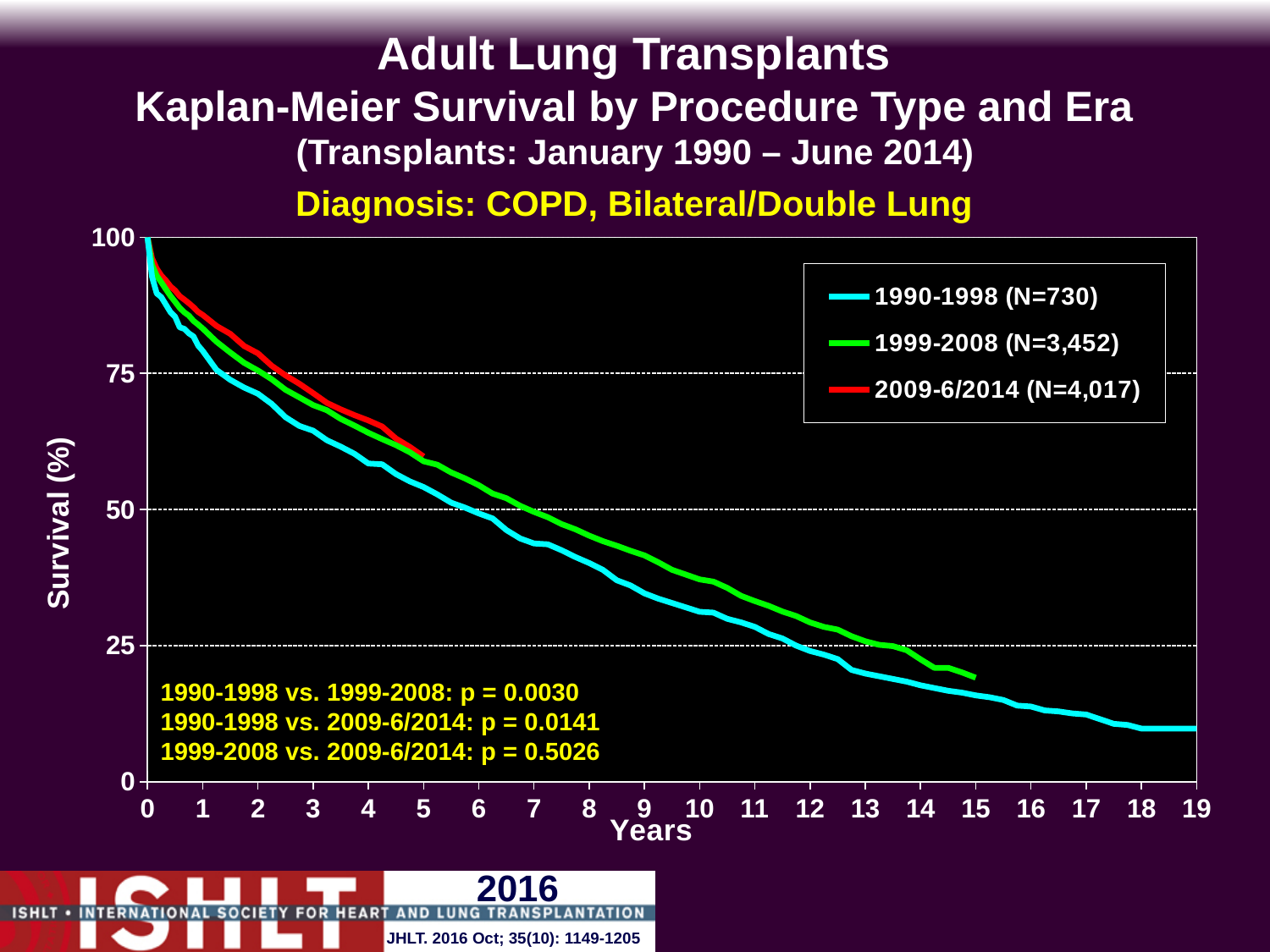
What p-value is given for 1990-1998 vs. 1999-2008? p = 0.0030 What is the N for the 1999-2008 era shown in the legend? 3,452 What kind of chart is shown on the slide? line chart At 10 years, which era has higher survival, 1990-1998 or 1999-2008? 1999-2008 How many series does the legend list? 3 Which series is drawn in red? 2009-6/2014 (N=4,017) Is the survival for the 1990-1998 era at 15 years greater or less than 25? less What is the N for the 2009-6/2014 era shown in the legend? 4,017 Is the survival for the 1990-1998 era at 5 years greater or less than 50? greater What p-value is given for 1999-2008 vs. 2009-6/2014? p = 0.5026 Is the survival for the 1999-2008 era at 10 years greater or less than 50? less Do the survival curves rise or fall as years increase? fall